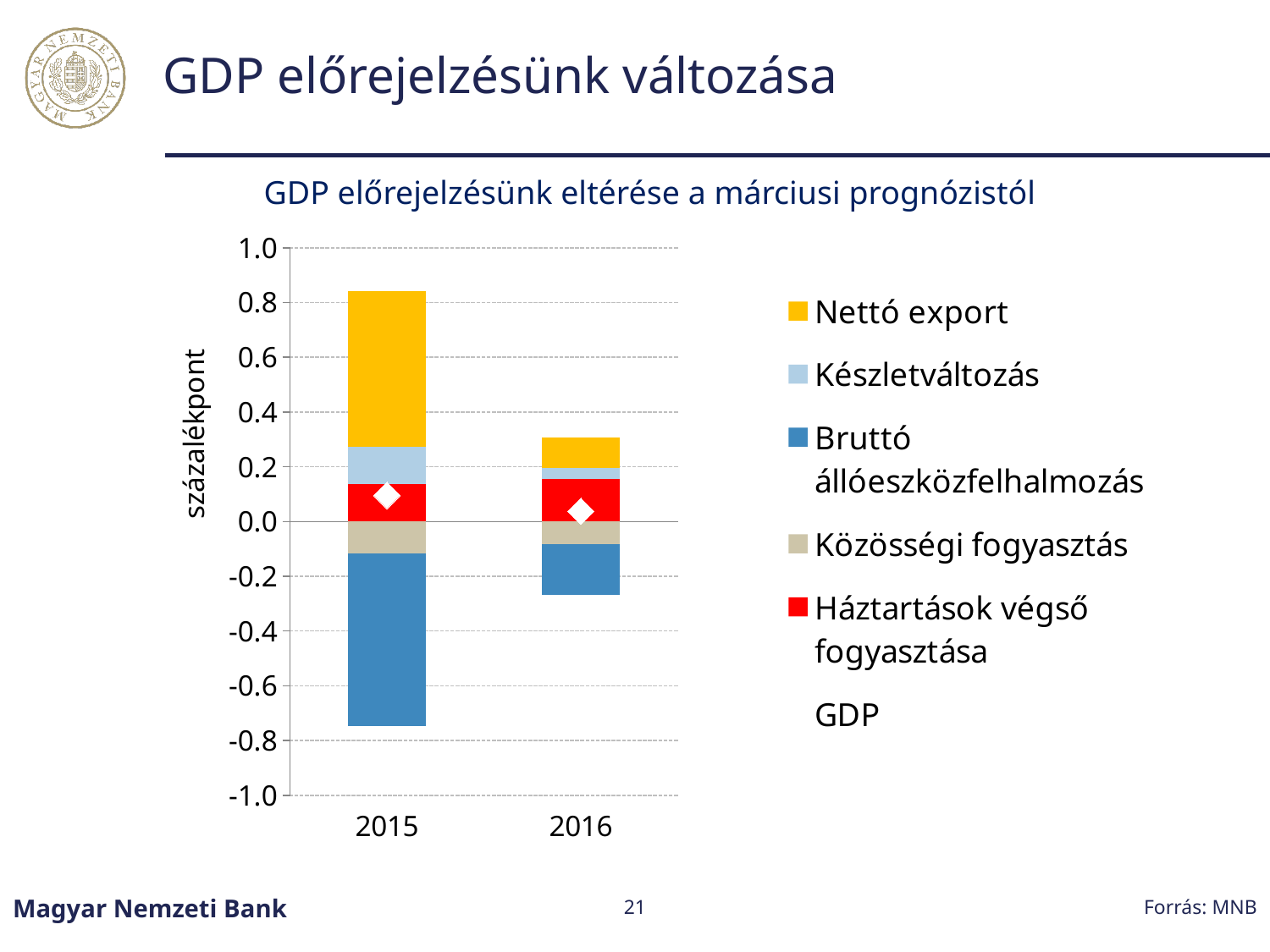
Which year has the larger Nettó export segment, 2015 or 2016? 2015 What is the label on the vertical axis of the chart? százalékpont Is the top of the stacked bar for 2016 greater or less than 0.4? less Is the bottom of the Bruttó állóeszközfelhalmozás segment for 2015 greater or less than -0.6? less What kind of chart is shown on the slide? Stacked bar chart Is the top of the stacked bar for 2015 greater or less than 0.6? greater How many entries does the chart's legend list? 6 How many years (categories) are shown on the x axis of the chart? 2 What is the title of the chart? GDP előrejelzésünk eltérése a márciusi prognózistól Which year has the higher GDP marker, 2015 or 2016? 2015